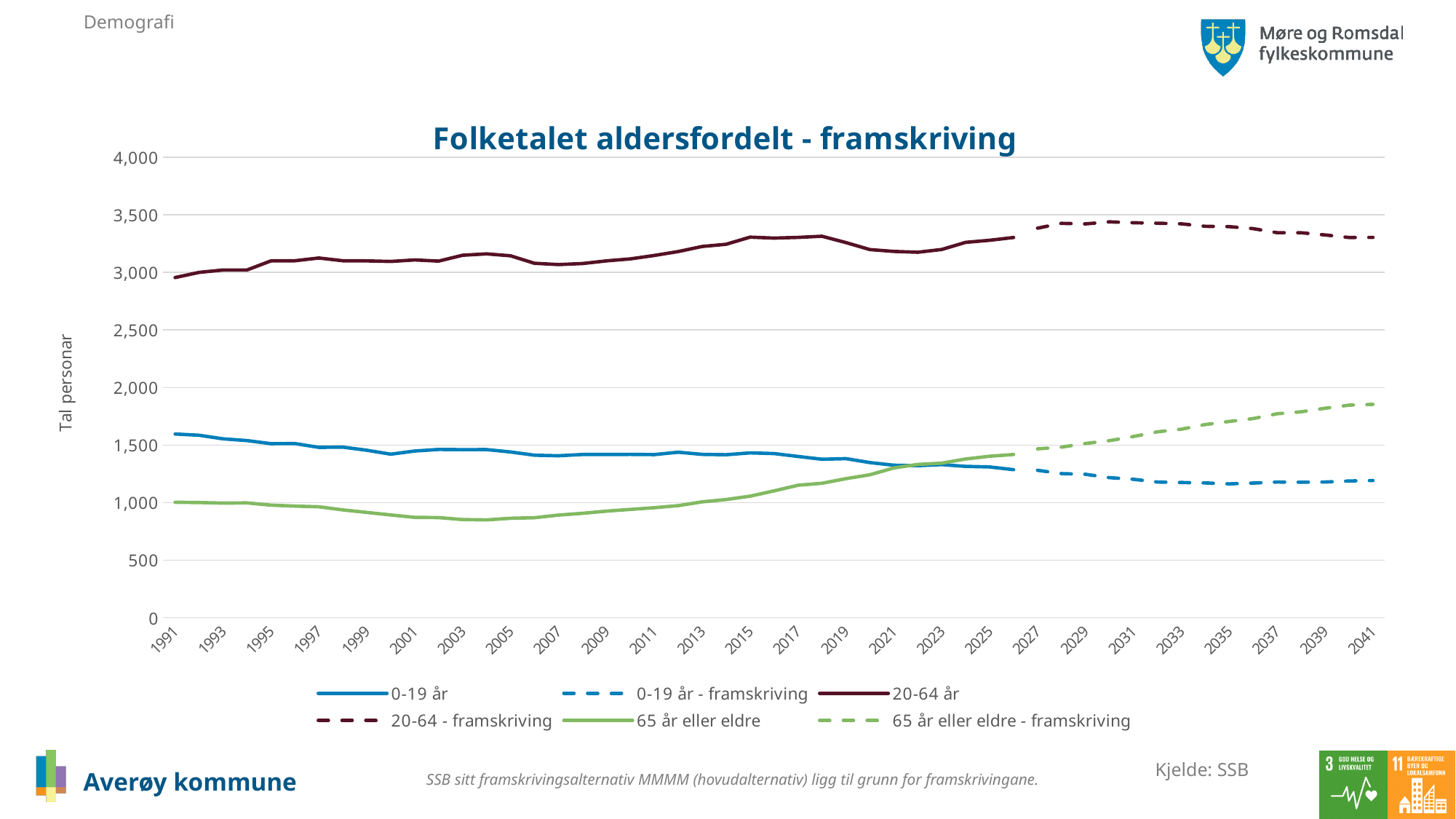
Does the 65 år eller eldre - framskriving series rise or fall from 2027 to 2041? rise What is the title of the chart? Folketalet aldersfordelt - framskriving Is the value for 65 år eller eldre - framskriving in 2041 greater or less than 1,500? greater What kind of chart is shown on the slide? line chart Is the value for 0-19 år - framskriving in 2041 greater or less than 1,500? less What is the label on the vertical axis? Tal personar Is the value for 65 år eller eldre in 2003 greater or less than 1,000? less In 2041, which is larger: 65 år eller eldre - framskriving or 0-19 år - framskriving? 65 år eller eldre - framskriving How many series does the legend list? 6 Which series has the highest values across the whole chart? 20-64 - framskriving